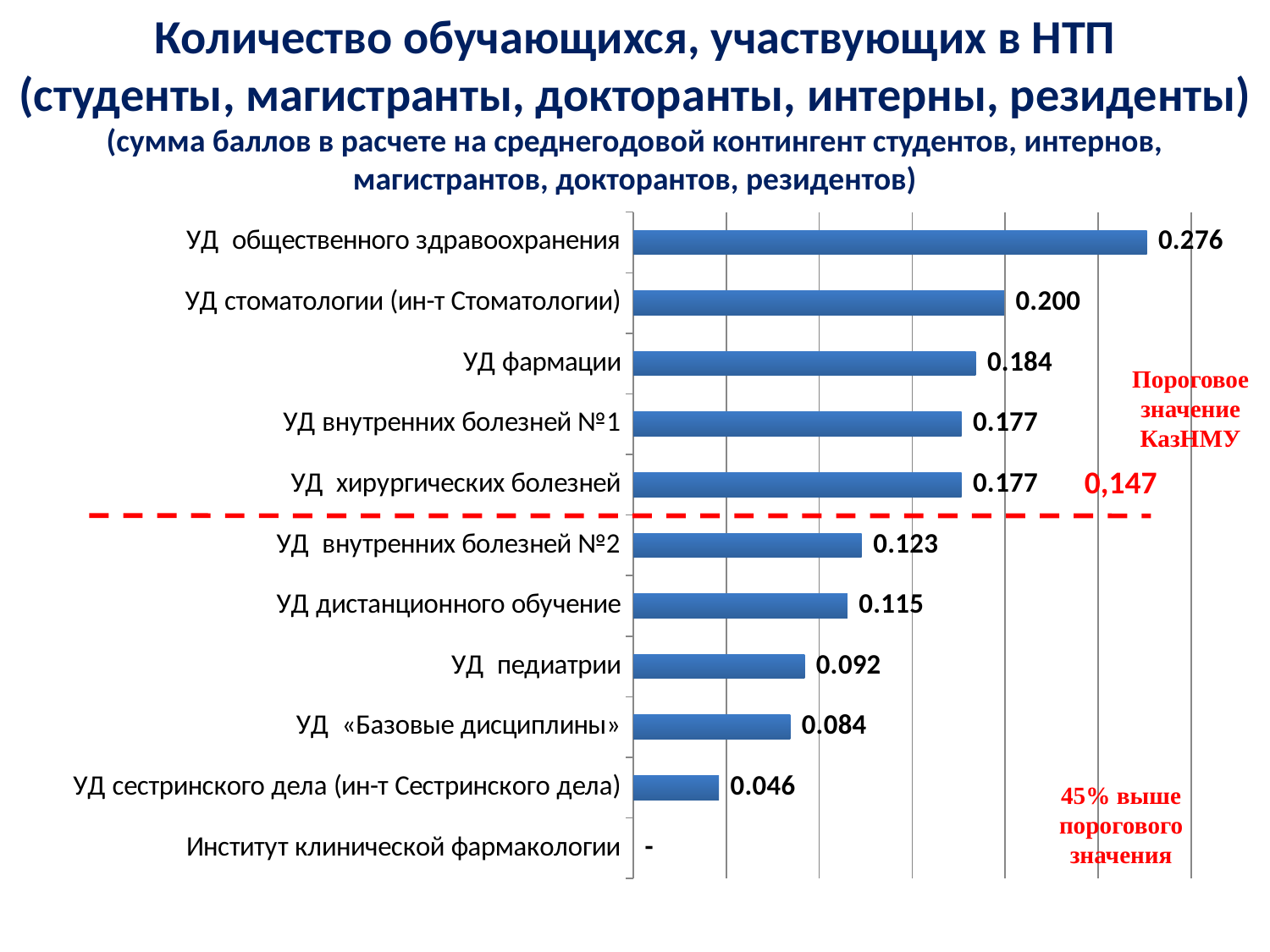
What is shown as the value for Институт клинической фармакологии? - What is the value for УД общественного здравоохранения? 0.276 Which is larger, the value for УД фармации or the value for УД внутренних болезней №1? УД фармации What is the value for УД стоматологии (ин-т Стоматологии)? 0.200 What is the difference between the values for УД общественного здравоохранения and УД стоматологии (ин-т Стоматологии)? 0.076 What is the value for УД педиатрии? 0.092 Which category has the highest value? УД общественного здравоохранения What is the difference between the values for УД внутренних болезней №2 and УД дистанционного обучение? 0.008 How many categories are listed on the chart? 11 Which category has the smallest bar with a printed value? УД сестринского дела (ин-т Сестринского дела) What threshold value (Пороговое значение КазНМУ) is marked by the red dashed line? 0,147 What kind of chart is shown on the slide? Bar chart